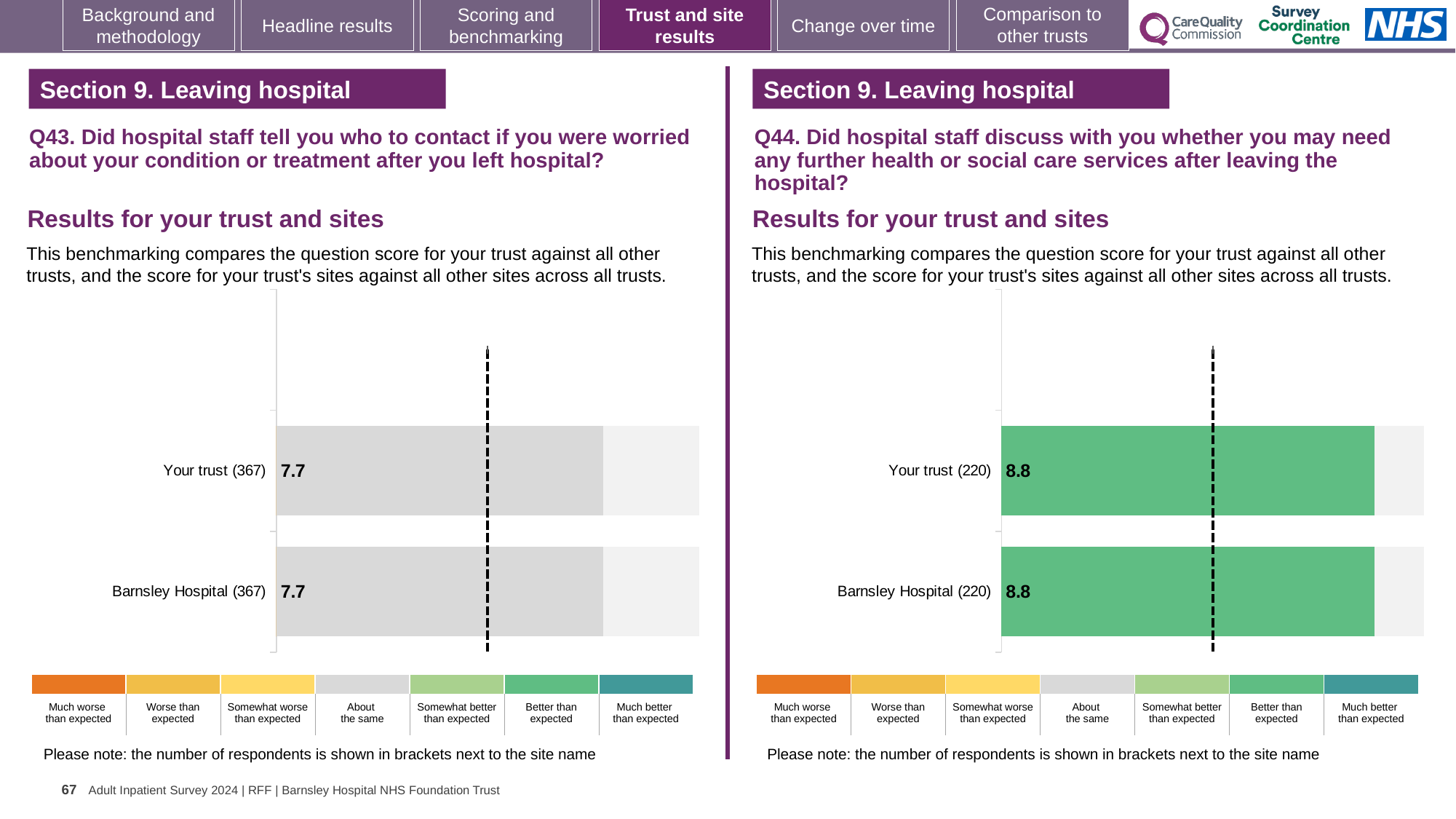
In the Q43 chart on the left, how many respondents are shown in brackets for Your trust? 367 What kind of chart is used in the Q44 chart on the right? Bar chart In the Q44 chart on the right, what is the score for Your trust? 8.8 How many bars are plotted in the Q43 chart on the left? 2 According to the colour key, which benchmarking category do the green bars in the Q44 chart on the right represent? Better than expected In the Q43 chart on the left, what is the difference between the score for Your trust and the score for Barnsley Hospital? 0.0 How many bars are plotted in the Q44 chart on the right? 2 In the Q43 chart on the left, what is the score for Barnsley Hospital? 7.7 In the Q43 chart on the left, what is the score for Your trust? 7.7 In the Q44 chart on the right, what is the difference between the score for Your trust and the score for Barnsley Hospital? 0.0 In the Q44 chart on the right, how many respondents are shown in brackets for Barnsley Hospital? 220 In the Q44 chart on the right, what is the score for Barnsley Hospital? 8.8